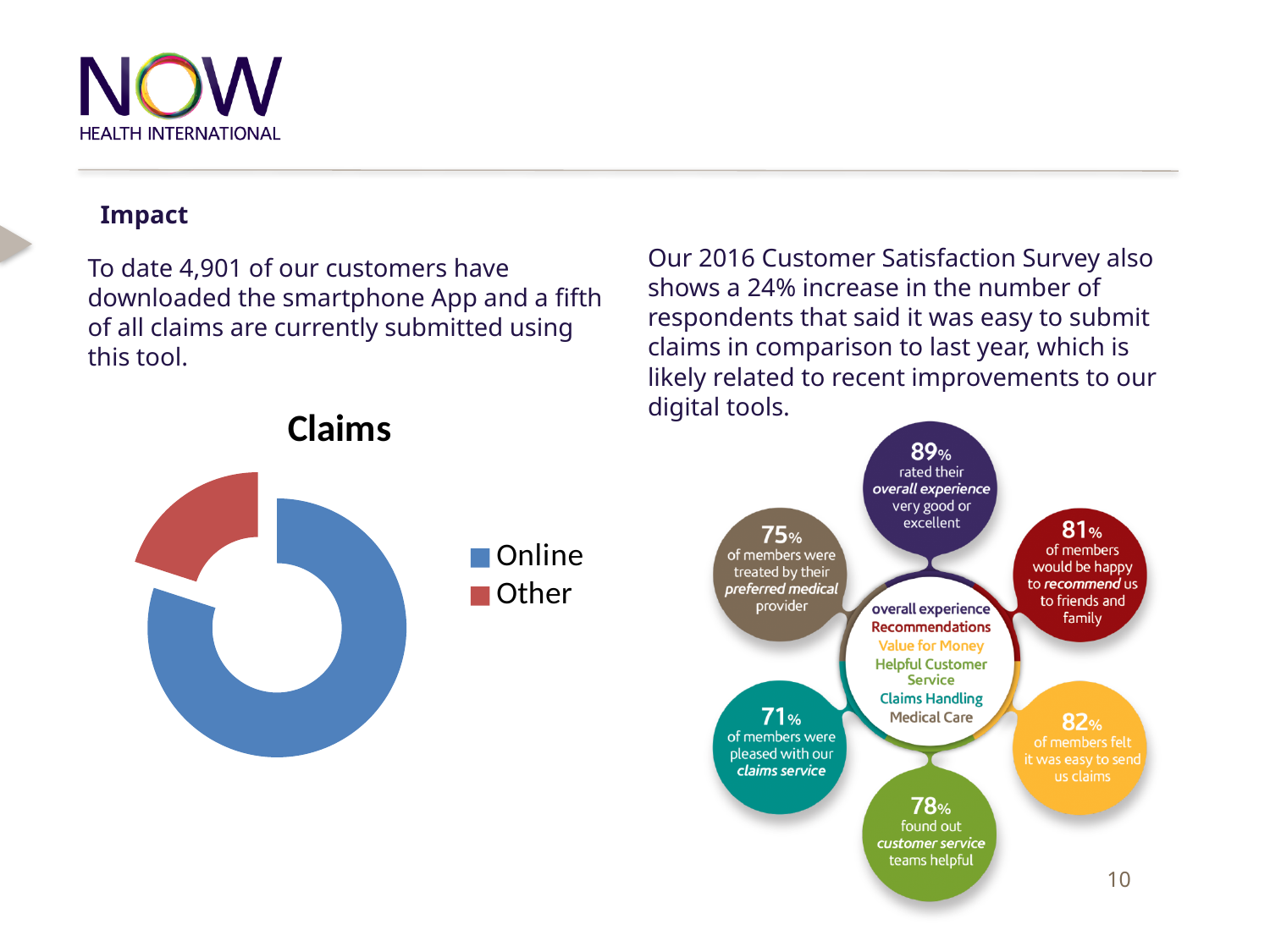
In the circular infographic on the right, what percentage of members felt it was easy to send claims? 82% In the circular infographic on the right, what is the difference between the share who would be happy to recommend us (81%) and the share who found customer service teams helpful (78%)? 3% In the "Claims" chart, which category has the largest slice? Online In the "Claims" chart, which slice is larger, Online or Other? Online What is the title of the doughnut chart on the left of the slide? Claims In the "Claims" chart, which colour represents the Other category? Red In the "Claims" chart, which category has the smallest slice? Other How many categories does the "Claims" chart show? 2 What kind of chart is the "Claims" chart? Doughnut chart In the circular infographic on the right, what percentage of members rated their overall experience very good or excellent? 89% How many entries does the legend of the "Claims" chart list? 2 In the circular infographic on the right, which statement has the lowest percentage? 71% of members were pleased with our claims service